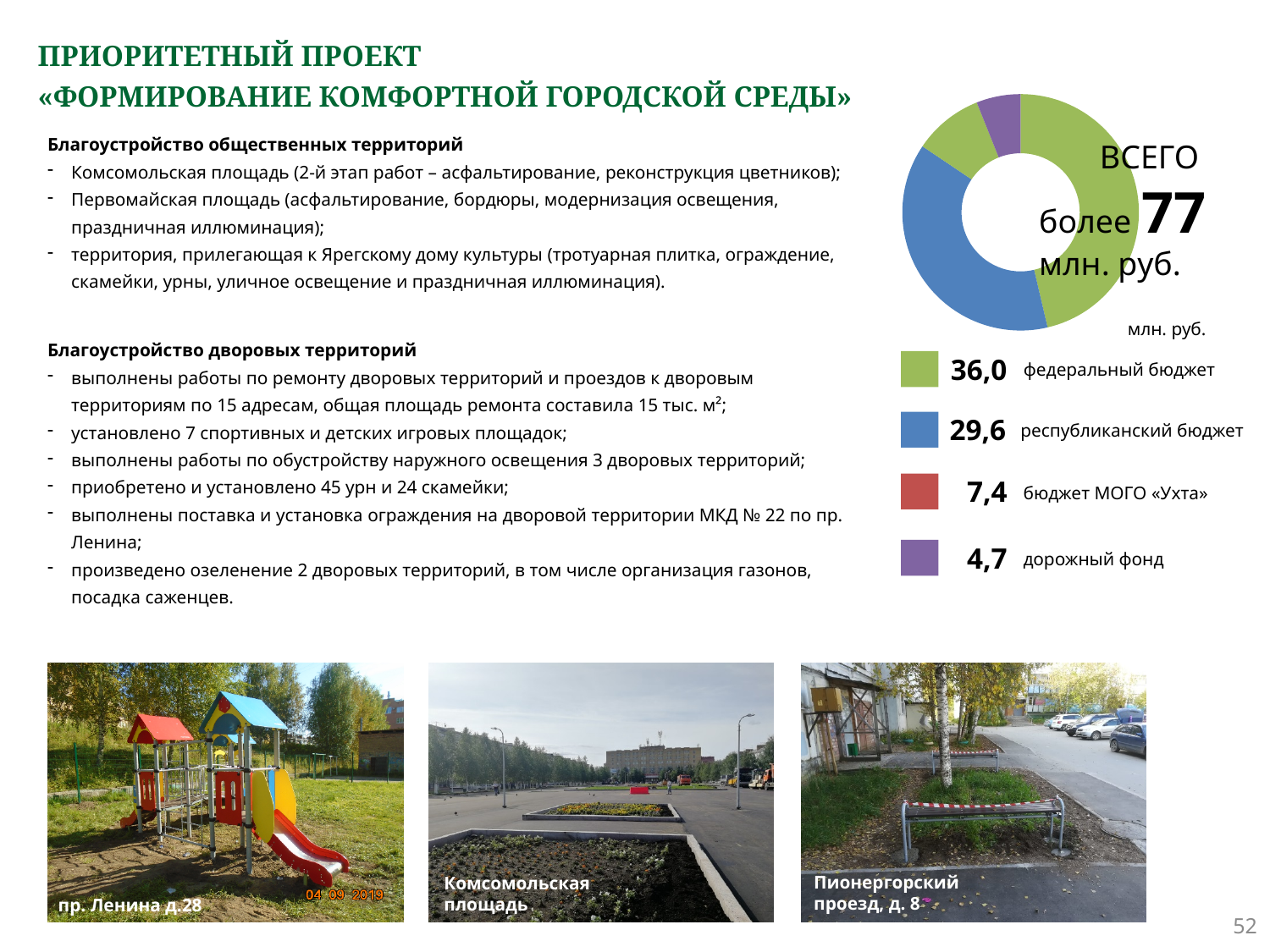
What total amount is written in the centre of the donut chart? более 77 млн. руб. What is the difference between федеральный бюджет and республиканский бюджет? 6,4 What colour represents республиканский бюджет in the chart? blue How many funding sources does the chart legend list? 4 What is the value for дорожный фонд in the chart? 4,7 Which funding source has the smallest value in the chart? дорожный фонд Which is larger, бюджет МОГО «Ухта» or дорожный фонд? бюджет МОГО «Ухта» Which funding source has the largest value in the chart? федеральный бюджет What is the value for бюджет МОГО «Ухта» in the chart? 7,4 What is the value for республиканский бюджет in the chart? 29,6 What is the value for федеральный бюджет in the chart? 36,0 What kind of chart is shown on the slide? pie chart (donut)